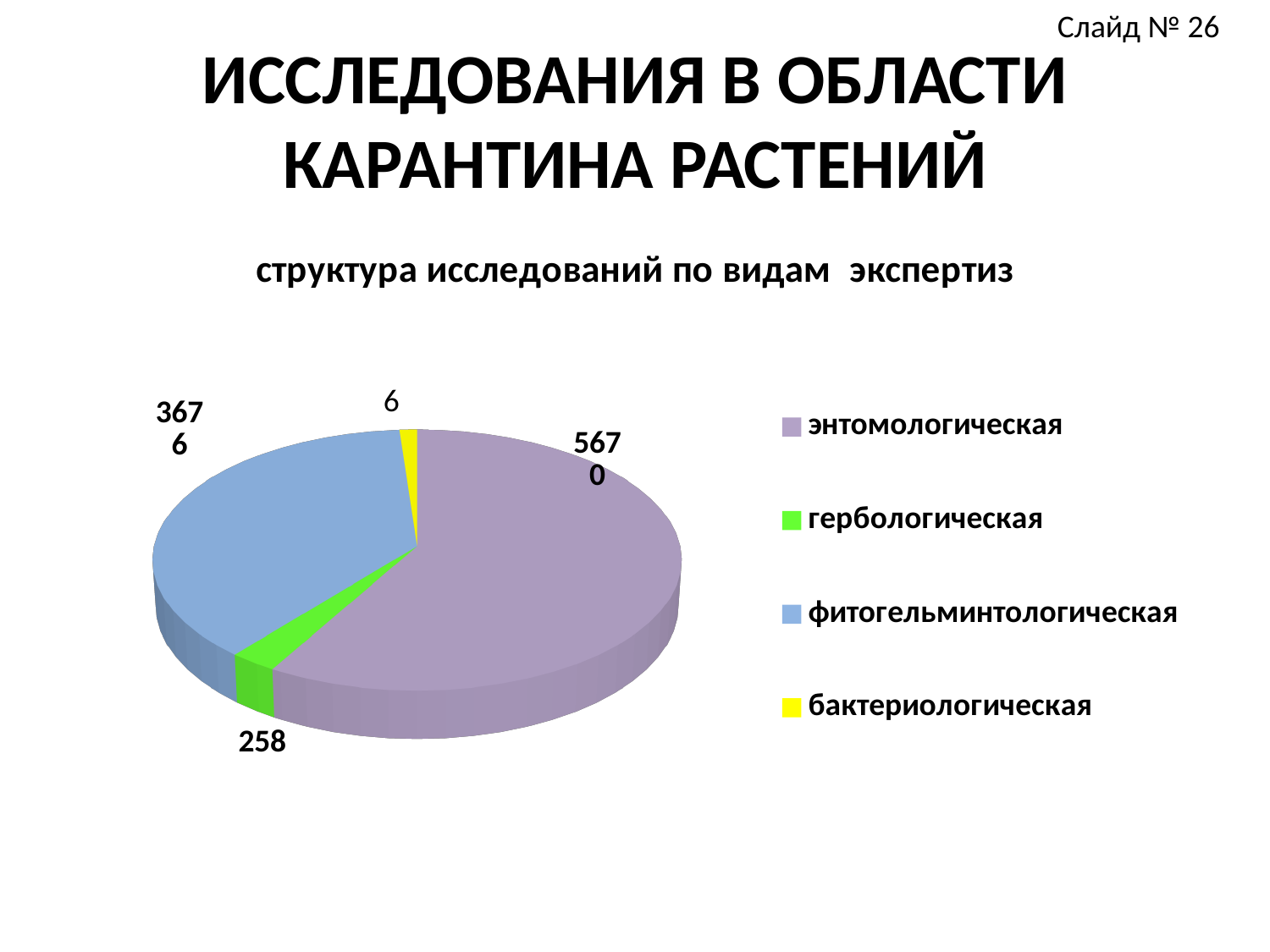
What is the value for энтомологическая? 5670 What is the value for гербологическая? 258 What is the title of the chart? структура исследований по видам экспертиз What colour is the slice for фитогельминтологическая? blue Which is larger, the value for фитогельминтологическая or the value for гербологическая? фитогельминтологическая Which category has the smallest slice of the pie? бактериологическая What is the value for фитогельминтологическая? 3676 Which category has the largest slice of the pie? энтомологическая What kind of chart is shown on the slide? pie chart How many categories does the legend of the pie chart list? 4